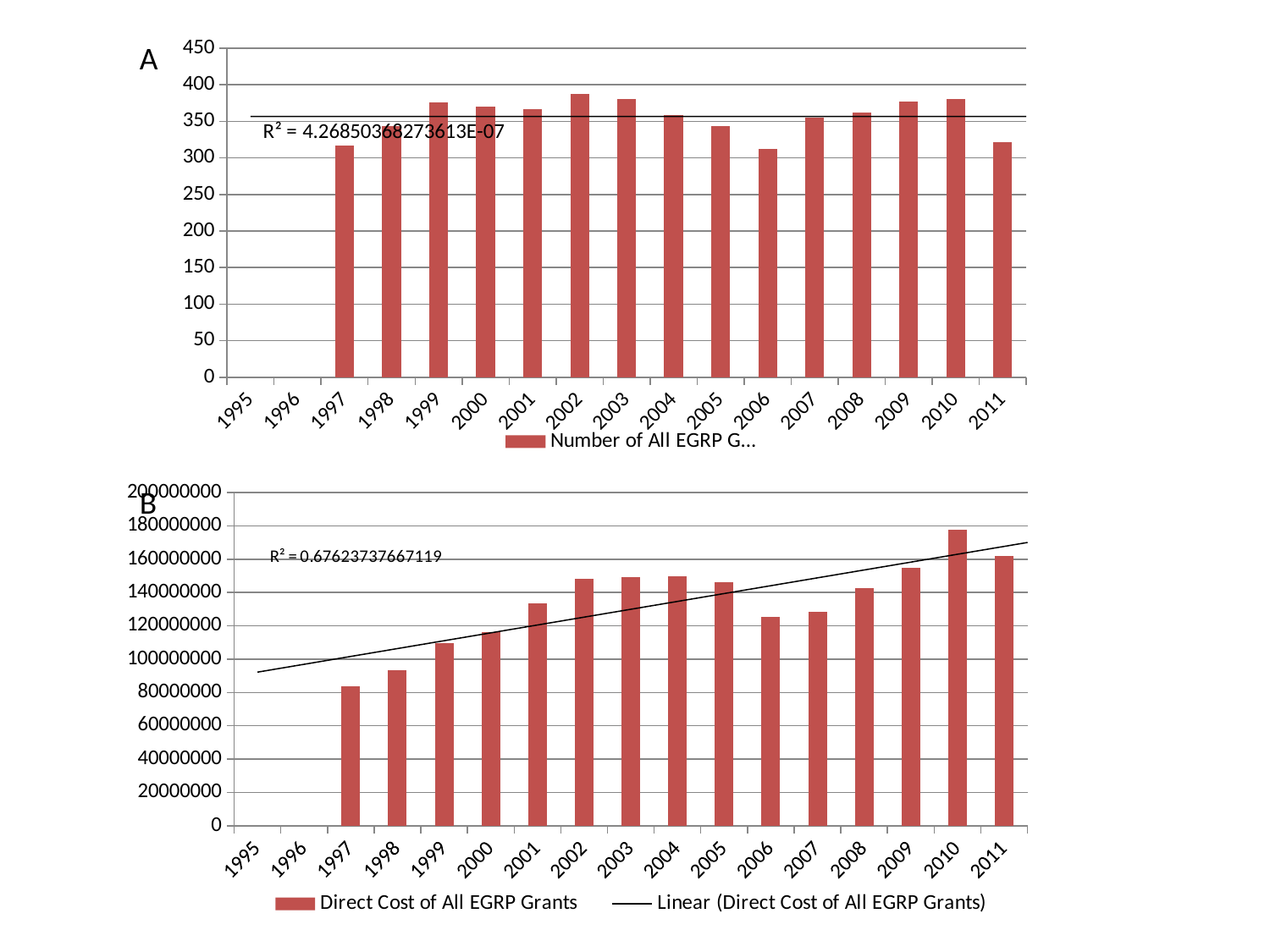
In chart B (the bottom chart), which year has the highest direct cost of all EGRP grants? 2010 In chart B (the bottom chart), is the value for 2010 greater or less than 160000000? greater In chart A (the top chart), is the value for 2002 greater or less than 350? greater What kind of chart is chart A (the top chart)? bar chart In chart B (the bottom chart), which year has the larger direct cost, 2010 or 2011? 2010 In chart A (the top chart), is the value for 2006 greater or less than 350? less In chart B (the bottom chart), which year has the larger direct cost, 1998 or 1999? 1999 What R² value is shown on chart B (the bottom chart)? 0.67623737667119 In chart B (the bottom chart), which year has the lowest direct cost of all EGRP grants? 1997 How many entries does the legend of chart B (the bottom chart) list? 2 In chart B (the bottom chart), how many years have a bar plotted? 15